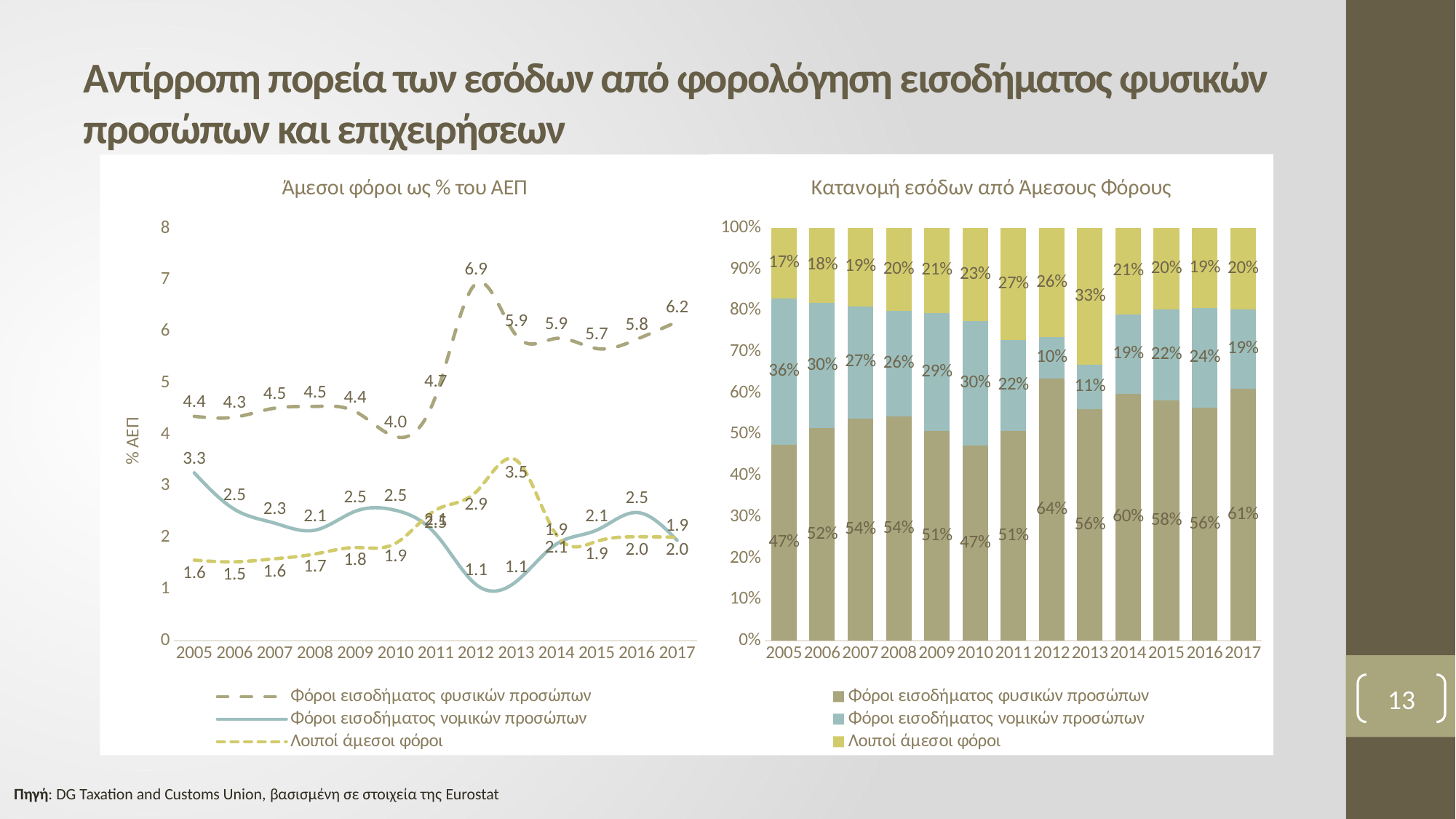
In the chart titled 'Άμεσοι φόροι ως % του ΑΕΠ', what is the difference between the 'Φόροι εισοδήματος φυσικών προσώπων' values in 2017 and 2010? 2.2 In the chart titled 'Κατανομή εσόδων από Άμεσους Φόρους', how many years are shown on the x axis? 13 What kind of chart is the one titled 'Κατανομή εσόδων από Άμεσους Φόρους'? Stacked bar chart In the chart titled 'Κατανομή εσόδων από Άμεσους Φόρους', in which year is the share of 'Λοιποί άμεσοι φόροι' highest? 2013 In the chart titled 'Άμεσοι φόροι ως % του ΑΕΠ', what is the highest value shown for 'Λοιποί άμεσοι φόροι'? 3.5 In the chart titled 'Άμεσοι φόροι ως % του ΑΕΠ', how many series does the legend list? 3 In the chart titled 'Κατανομή εσόδων από Άμεσους Φόρους', in which year is the share of 'Φόροι εισοδήματος νομικών προσώπων' lowest? 2012 What kind of chart is the one titled 'Άμεσοι φόροι ως % του ΑΕΠ'? Line chart In the chart titled 'Άμεσοι φόροι ως % του ΑΕΠ', in which year does 'Φόροι εισοδήματος φυσικών προσώπων' reach its highest value? 2012 In the chart titled 'Κατανομή εσόδων από Άμεσους Φόρους', what is the share of 'Φόροι εισοδήματος φυσικών προσώπων' in 2012? 64% In the chart titled 'Άμεσοι φόροι ως % του ΑΕΠ', what is the value for 'Φόροι εισοδήματος νομικών προσώπων' in 2005? 3.3 In the chart titled 'Άμεσοι φόροι ως % του ΑΕΠ', what is the value for 'Φόροι εισοδήματος φυσικών προσώπων' in 2012? 6.9